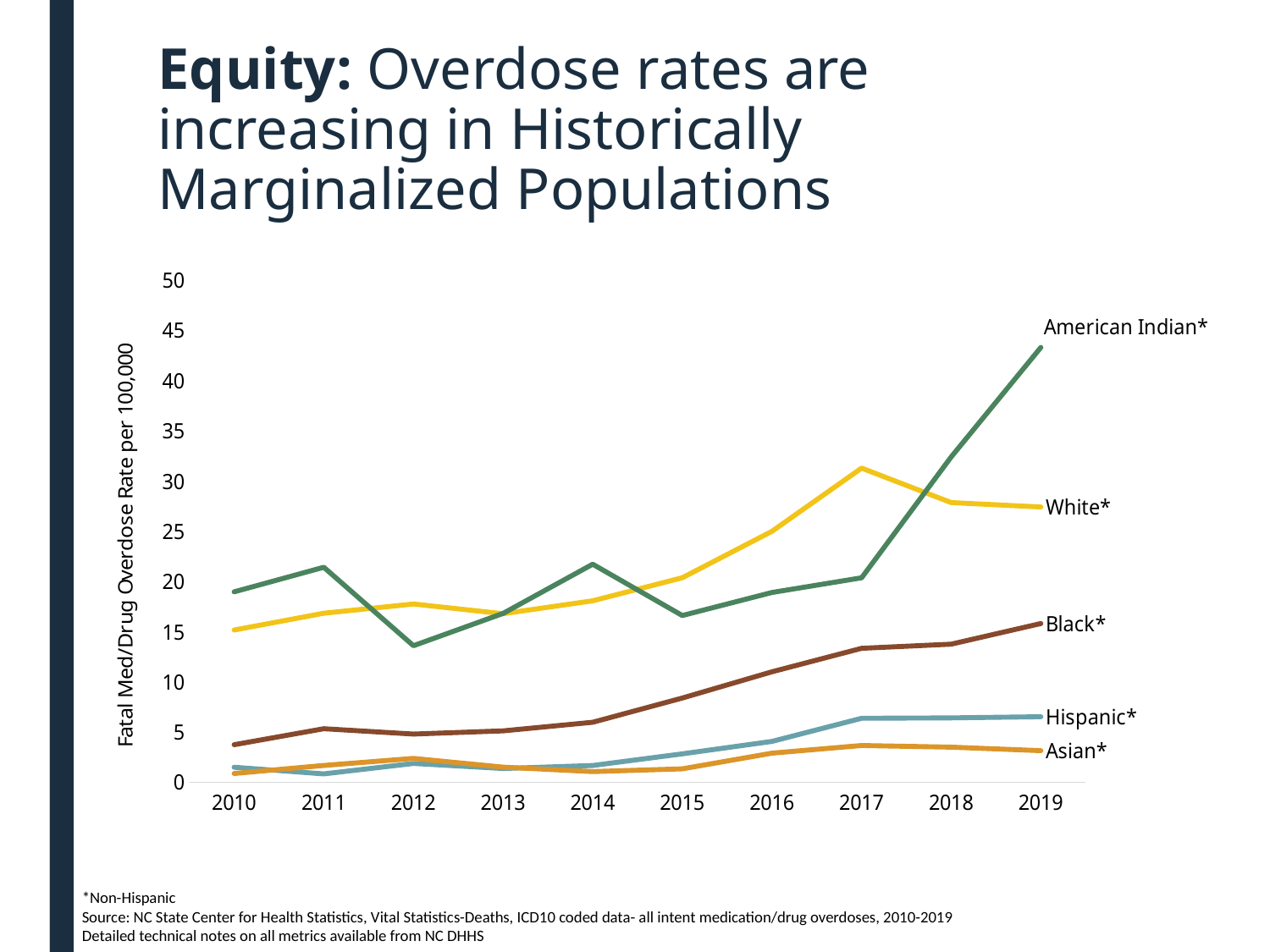
Does the overdose rate for Black* rise or fall from 2010 to 2019? rise How many years are shown along the x axis of the chart? 10 Is the overdose rate for Asian* in 2019 greater or less than 5? less Which population group has the highest overdose rate in 2017? White* In 2015, which group has the higher overdose rate, White* or American Indian*? White* What is the label on the y axis of the chart? Fatal Med/Drug Overdose Rate per 100,000 Which population group has the lowest overdose rate in 2019? Asian* Is the overdose rate for American Indian* in 2012 greater or less than 15? less Which population group has the highest overdose rate in 2019? American Indian* Is the overdose rate for American Indian* in 2019 greater or less than 40? greater What kind of chart is shown on the slide? line chart How many series (population groups) are plotted on the chart? 5